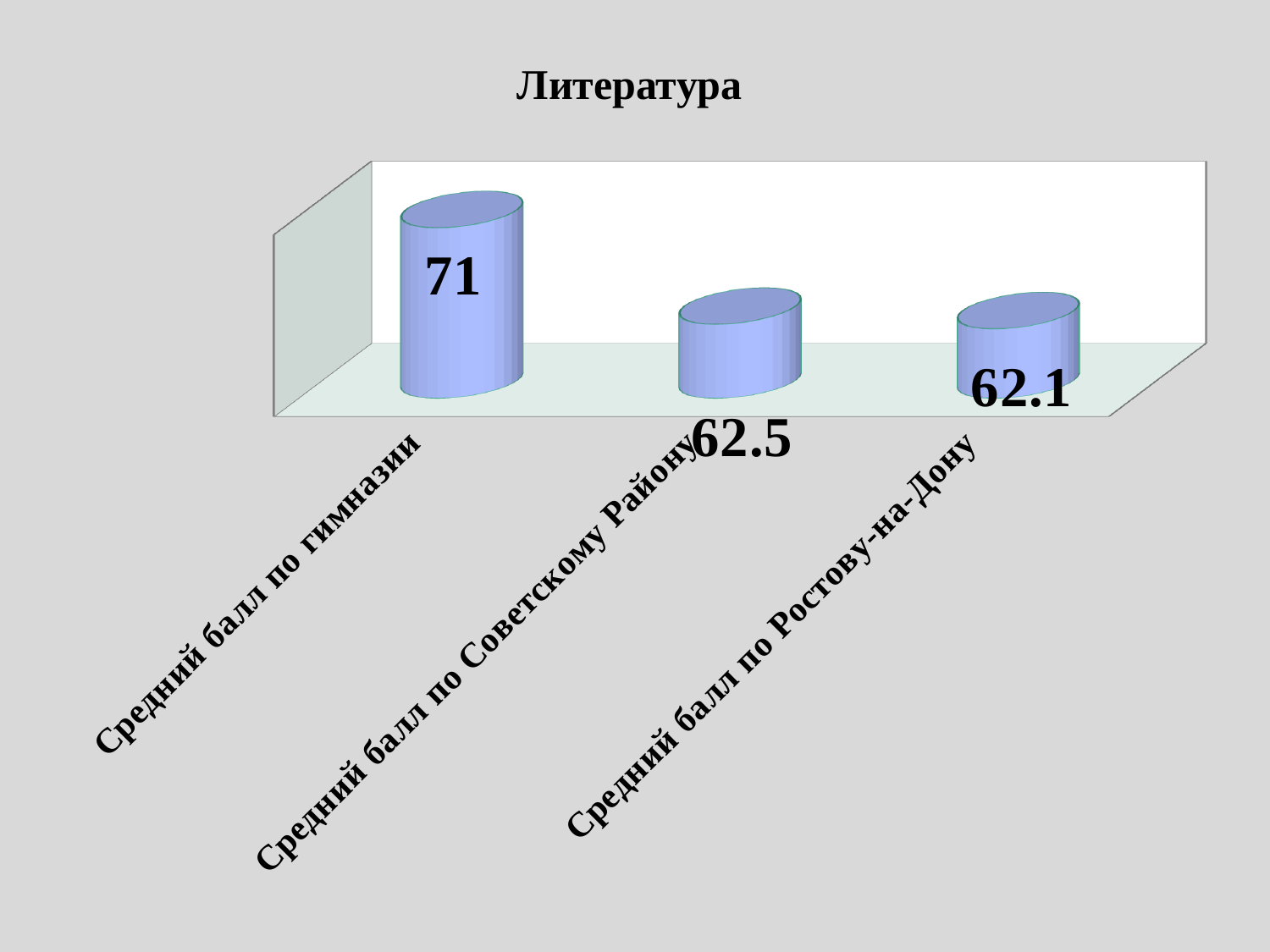
What is the value for Средний балл по гимназии? 71 Which is larger: the value for Средний балл по гимназии or the value for Средний балл по Ростову-на-Дону? Средний балл по гимназии What kind of chart is shown on the slide? Bar chart What is the difference between the value for Средний балл по Советскому Району and the value for Средний балл по Ростову-на-Дону? 0.4 What is the difference between the value for Средний балл по гимназии and the value for Средний балл по Советскому Району? 8.5 What is the value for Средний балл по Советскому Району? 62.5 What is the title of the chart? Литература Which category has the lowest value? Средний балл по Ростову-на-Дону How many categories are shown in the chart? 3 What is the difference between the value for Средний балл по гимназии and the value for Средний балл по Ростову-на-Дону? 8.9 Which category has the highest value? Средний балл по гимназии What is the value for Средний балл по Ростову-на-Дону? 62.1